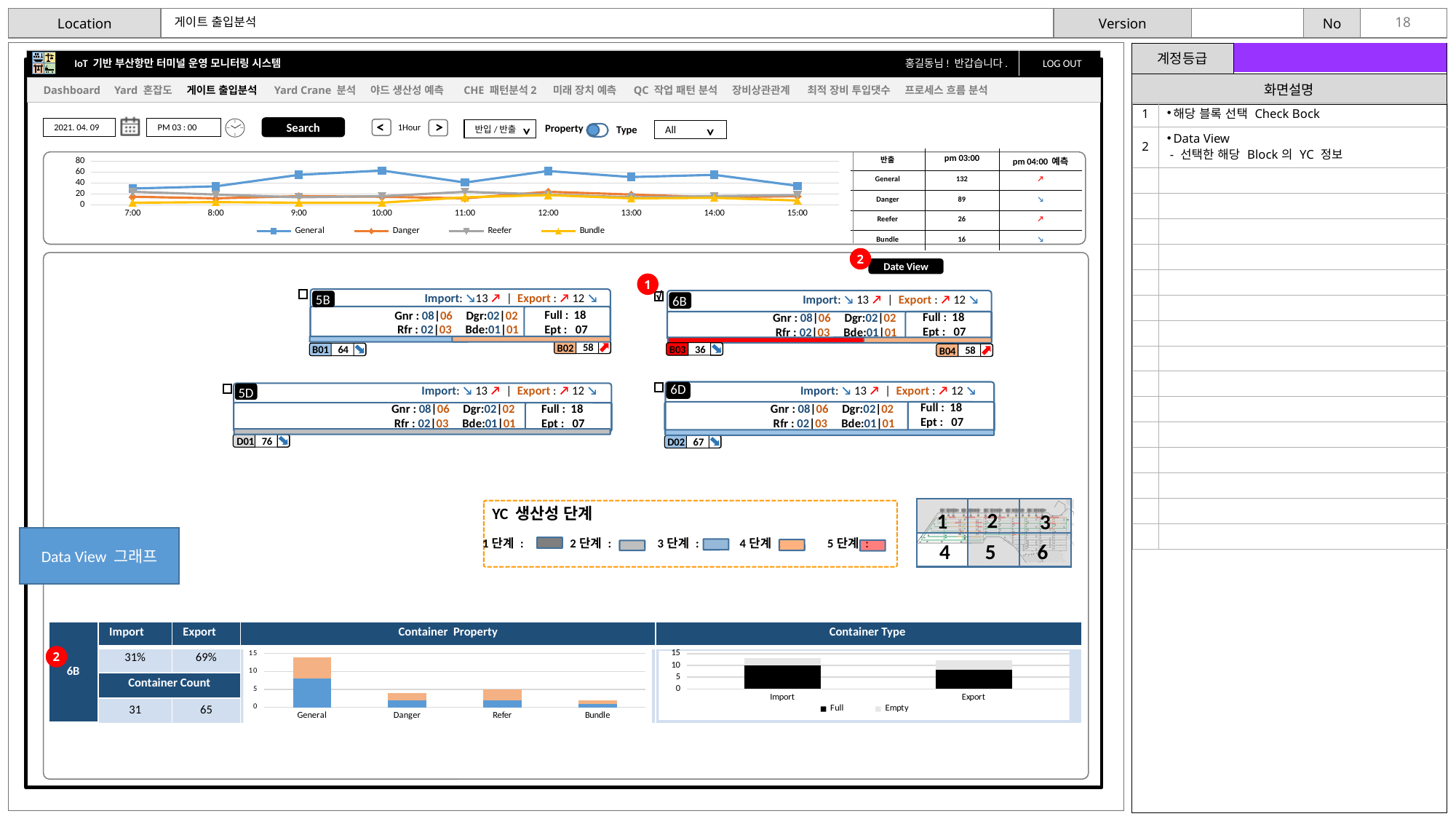
What kind of chart is the chart at the top of the slide showing General, Danger, Reefer and Bundle over time? line chart In the Container Property chart, which category has the tallest bar? General In the Container Property chart, is the total bar height for General greater or less than 10? greater How many categories are shown on the x axis of the Container Property chart? 4 How many series does the legend of the Container Type chart list? 2 How many series does the legend of the top line chart list? 4 In the top line chart, is the value for General at 7:00 greater or less than 40? less What kind of chart is the Container Property chart? bar chart How many time points are shown on the x axis of the top line chart? 9 In the top line chart, which series has the highest values across the time points? General In the top line chart, is the value for General at 10:00 greater or less than 40? greater What are the legend entries of the Container Type chart? Full, Empty